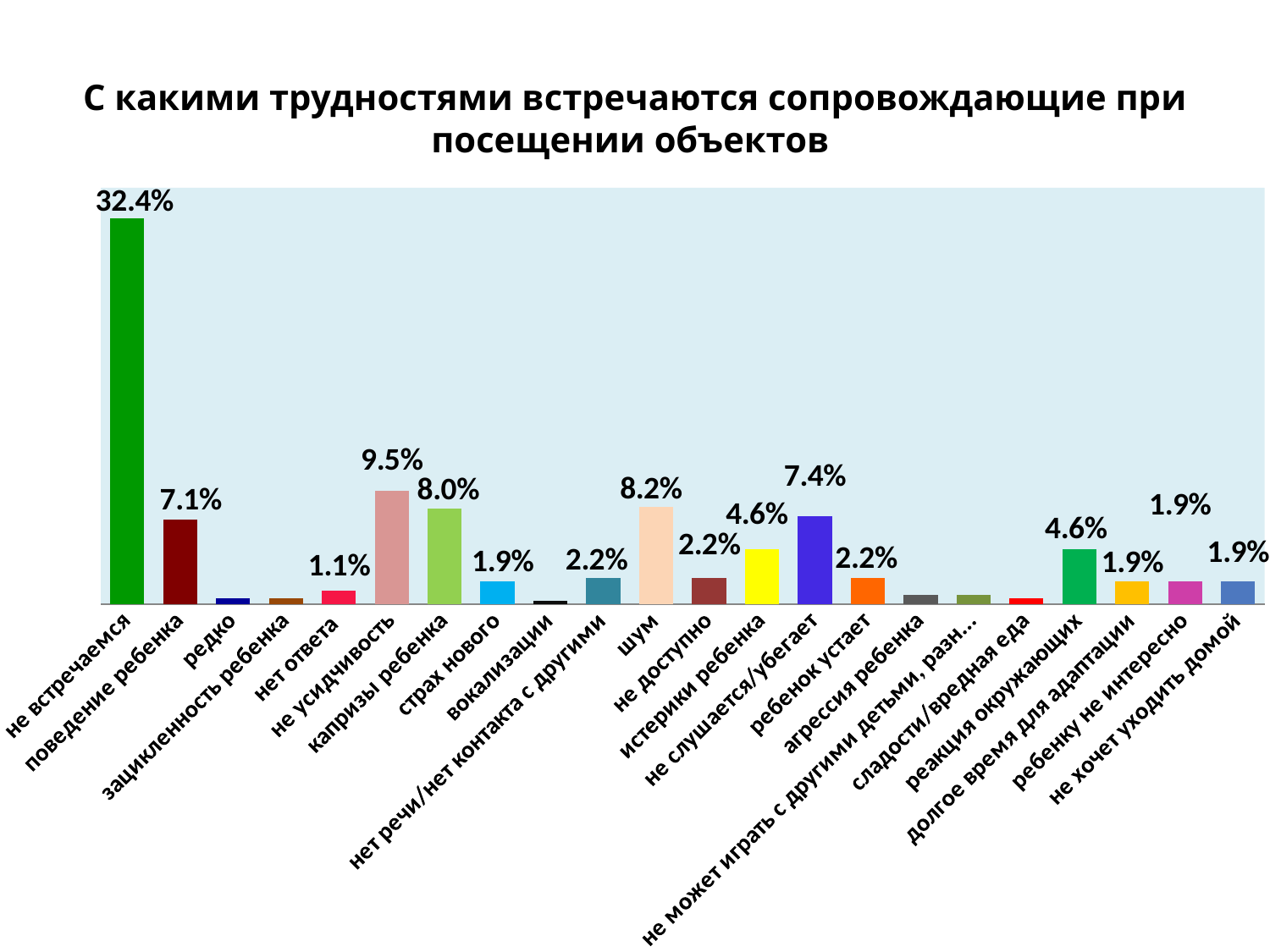
What is the value for "не встречаемся"? 32.4% What is the title of the chart? С какими трудностями встречаются сопровождающие при посещении объектов How many categories are shown on the x axis? 22 What is the value for "шум"? 8.2% What is the value for "реакция окружающих"? 4.6% Which is larger, the value for "шум" or the value for "не слушается/убегает"? шум What is the difference between the values for "не усидчивость" and "капризы ребенка"? 1.5% What type of chart is shown on the slide? bar chart Which category has the highest value? не встречаемся What is the value for "не усидчивость"? 9.5% What is the value for "не слушается/убегает"? 7.4% What is the difference between the values for "не встречаемся" and "поведение ребенка"? 25.3%